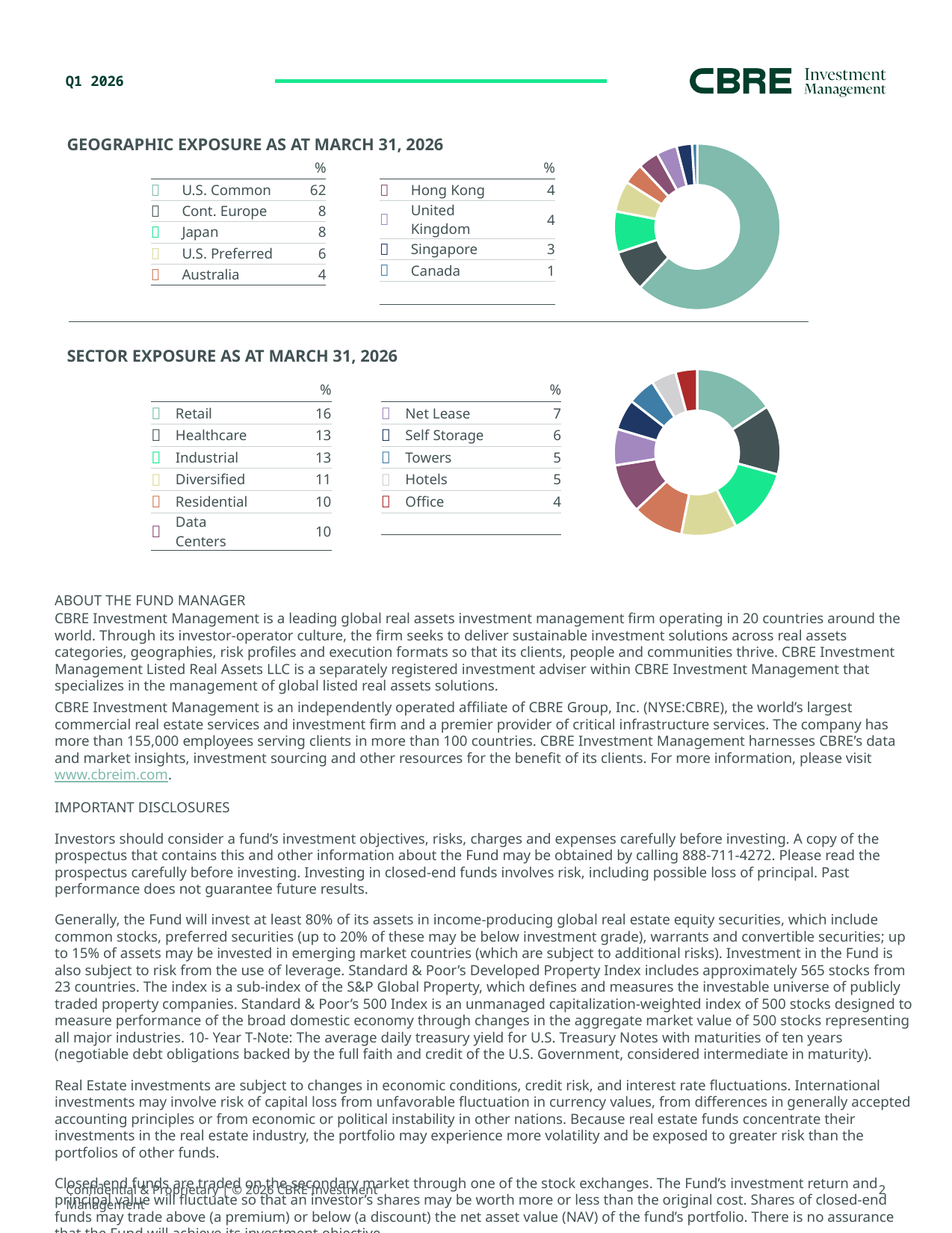
In the Geographic Exposure chart, how many categories are shown? 9 In the Geographic Exposure chart, which category has the largest share? U.S. Common In the Sector Exposure chart, how many sectors are shown? 11 In the Geographic Exposure chart, what percentage is U.S. Common? 62 What type of chart is used for Geographic Exposure? Donut chart In the Geographic Exposure chart, which category has the smallest share? Canada In the Geographic Exposure chart, what is the difference in percentage points between U.S. Common and Japan? 54 In the Sector Exposure chart, which sector has the smallest share? Office In the Sector Exposure chart, which sector has the largest share? Retail In the Sector Exposure chart, which is larger, Diversified or Net Lease? Diversified In the Sector Exposure chart, what percentage is Retail? 16 In the Sector Exposure chart, what is the difference in percentage points between Healthcare and Self Storage? 7